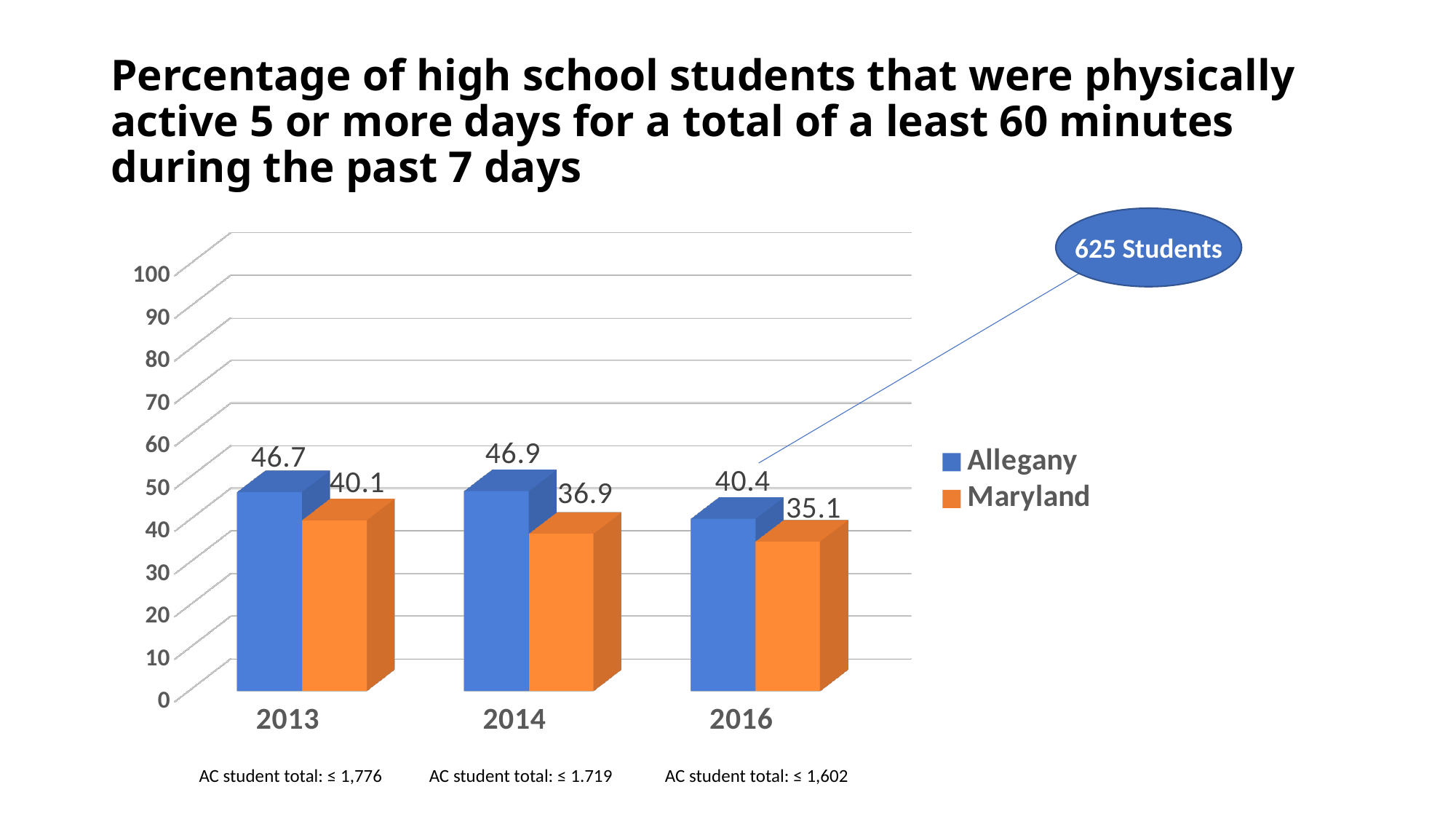
Is the value for Allegany in 2016 greater or less than 50? less What is the difference between the Allegany and Maryland values in 2013? 6.6 Which is larger in 2016, the Allegany value or the Maryland value? Allegany How many years are shown on the x axis? 3 What is the value for Maryland in 2014? 36.9 What is the value for Allegany in 2013? 46.7 How many series does the legend list? 2 Do the Maryland values rise or fall from 2013 to 2016? fall What kind of chart is shown on the slide? bar chart In which year is the Maryland value lowest? 2016 In which year is the Allegany value highest? 2014 What is the value for Maryland in 2016? 35.1